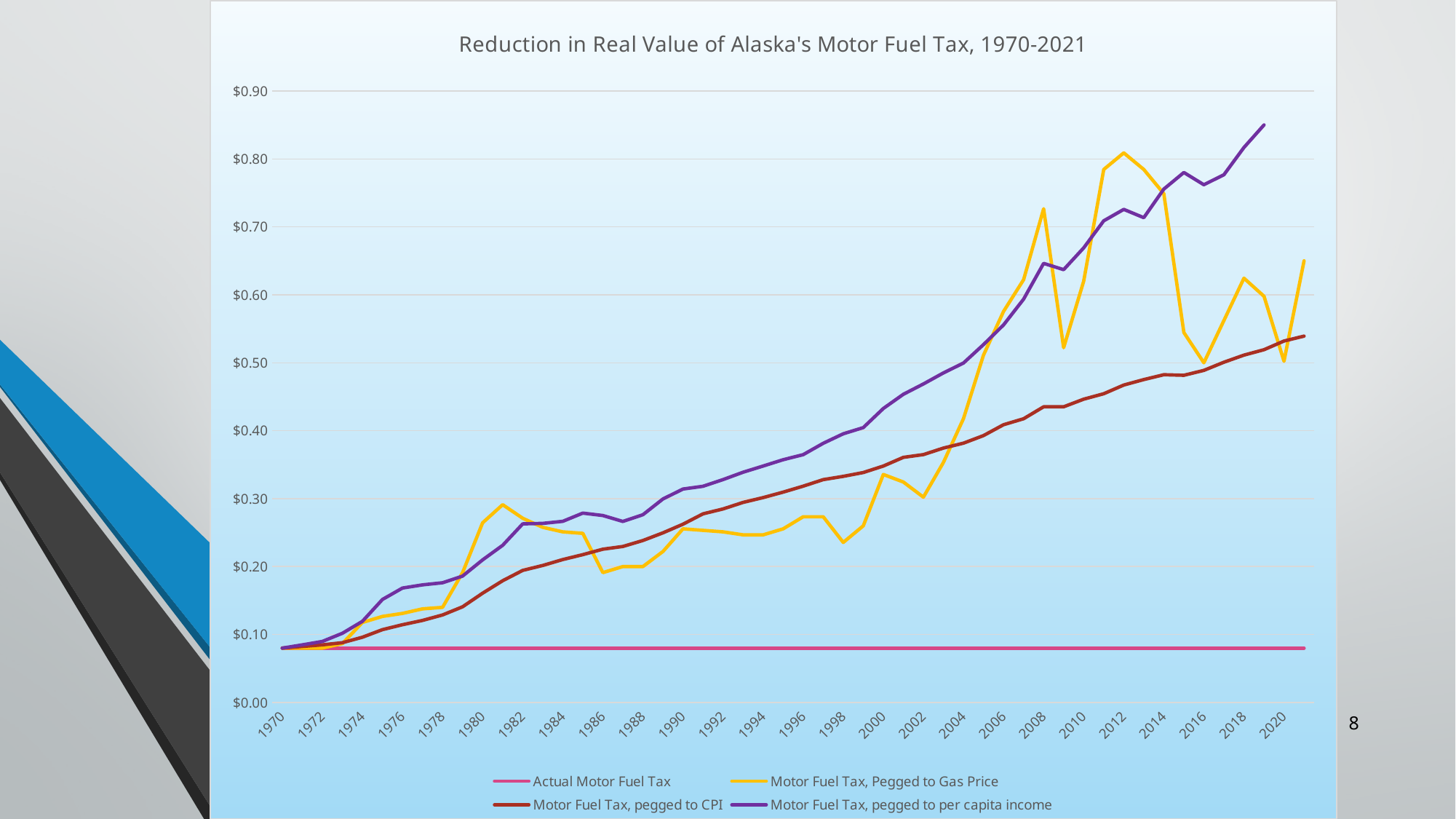
What kind of chart is shown on the slide? line chart Is the value of 'Motor Fuel Tax, pegged to CPI' in 2021 greater or less than $0.50? greater Which series reaches the highest value on the chart in 2021? Motor Fuel Tax, Pegged to Gas Price Is the value of 'Motor Fuel Tax, Pegged to Gas Price' in 2008 greater or less than $0.70? greater Which series stays flat across the whole period from 1970 to 2021? Actual Motor Fuel Tax In 1998, which is higher: 'Motor Fuel Tax, pegged to CPI' or 'Motor Fuel Tax, Pegged to Gas Price'? Motor Fuel Tax, pegged to CPI How many series does the legend list? 4 Does the 'Motor Fuel Tax, pegged to CPI' line rise or fall from 1970 to 2021? rise Is the value of 'Actual Motor Fuel Tax' greater or less than $0.10? less What is the title of the chart? Reduction in Real Value of Alaska's Motor Fuel Tax, 1970-2021